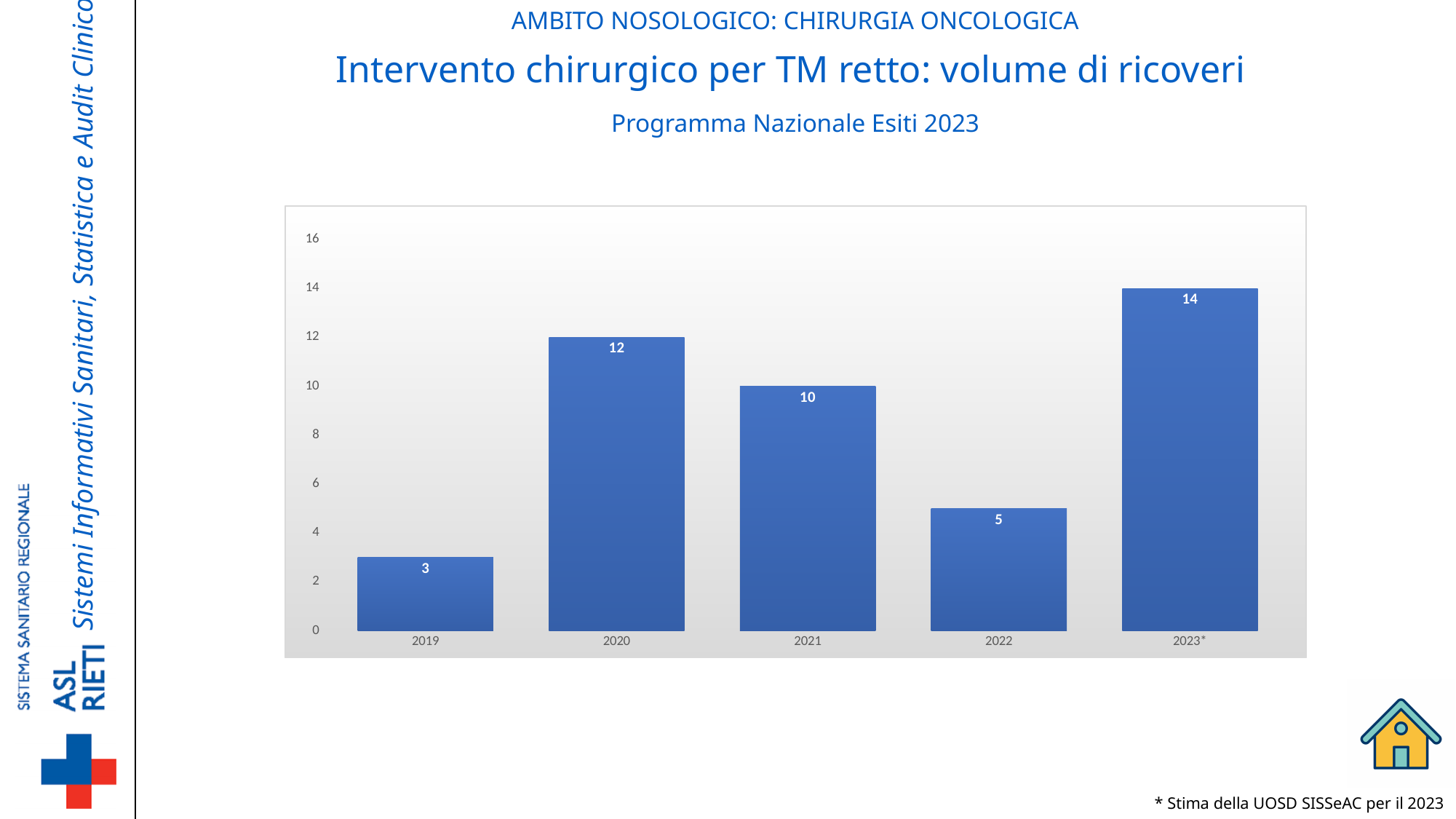
Which year has the lowest value? 2019 What is the value for 2023*? 14 Does the value rise or fall from 2021 to 2022? fall Which year has the highest value? 2023* What kind of chart is shown on the slide? bar chart What is the difference between the values for 2023* and 2019? 11 What is the value for 2019? 3 What is the difference between the values for 2020 and 2021? 2 What is the value for 2022? 5 Which is larger, the value for 2021 or the value for 2022? 2021 How many years are shown on the x axis? 5 What is the value for 2020? 12